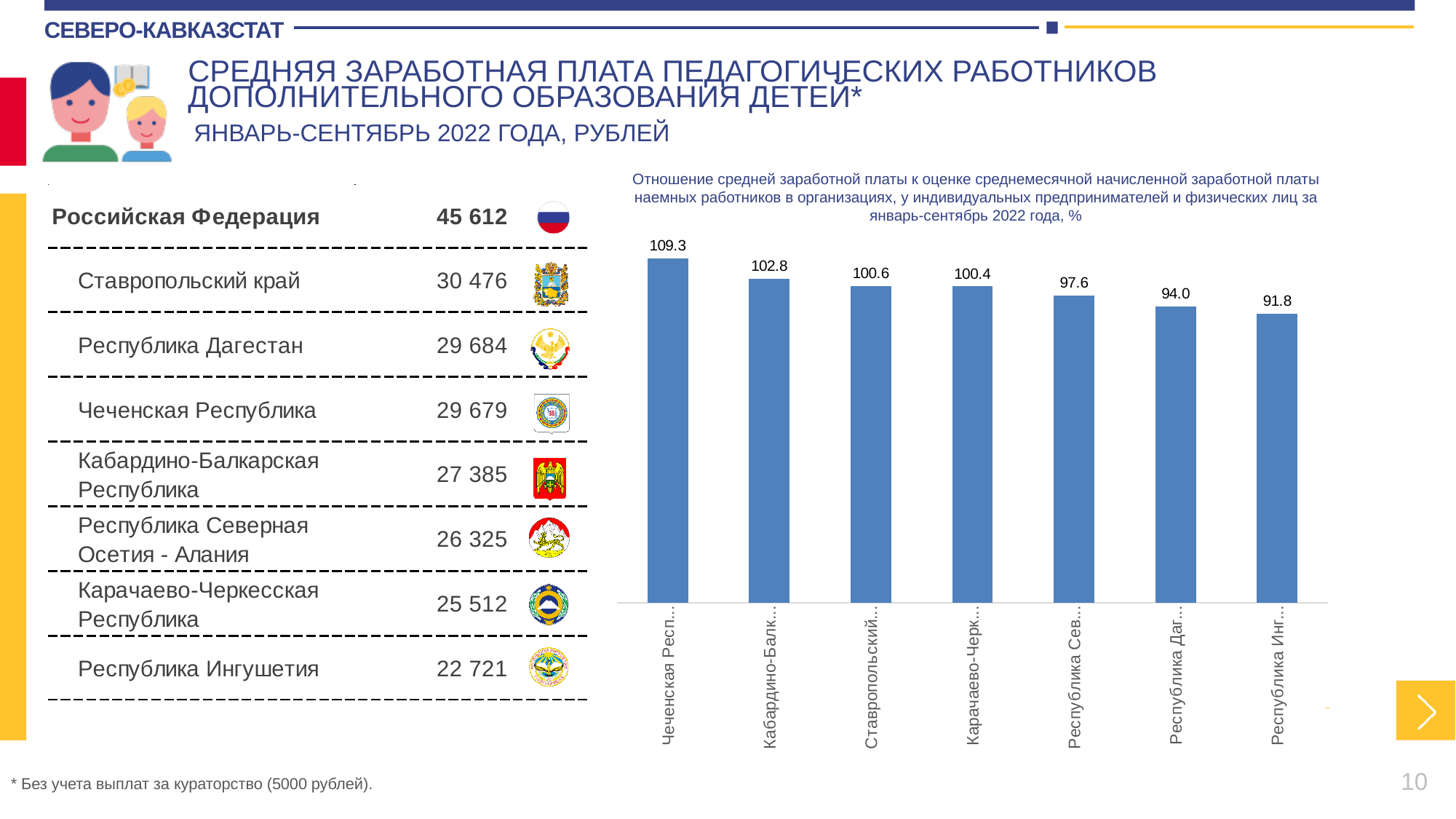
How many regions (bars) are shown in the bar chart? 7 Do the values in the bar chart rise or fall from left to right? fall What is the difference between the values for Кабардино-Балкарская Республика and Карачаево-Черкесская Республика in the bar chart? 2.4 Which region has the highest bar in the chart? Чеченская Республика How many bars in the chart have a value above 100? 4 What value is shown for Республика Дагестан in the bar chart? 94.0 What value is shown for Чеченская Республика in the bar chart? 109.3 Which has the larger value in the bar chart: Кабардино-Балкарская Республика or Ставропольский край? Кабардино-Балкарская Республика What type of chart is shown on the slide? bar chart What is the difference between the values for Чеченская Республика and Республика Ингушетия in the bar chart? 17.5 What value is shown for Республика Северная Осетия in the bar chart? 97.6 Which region has the lowest bar in the chart? Республика Ингушетия